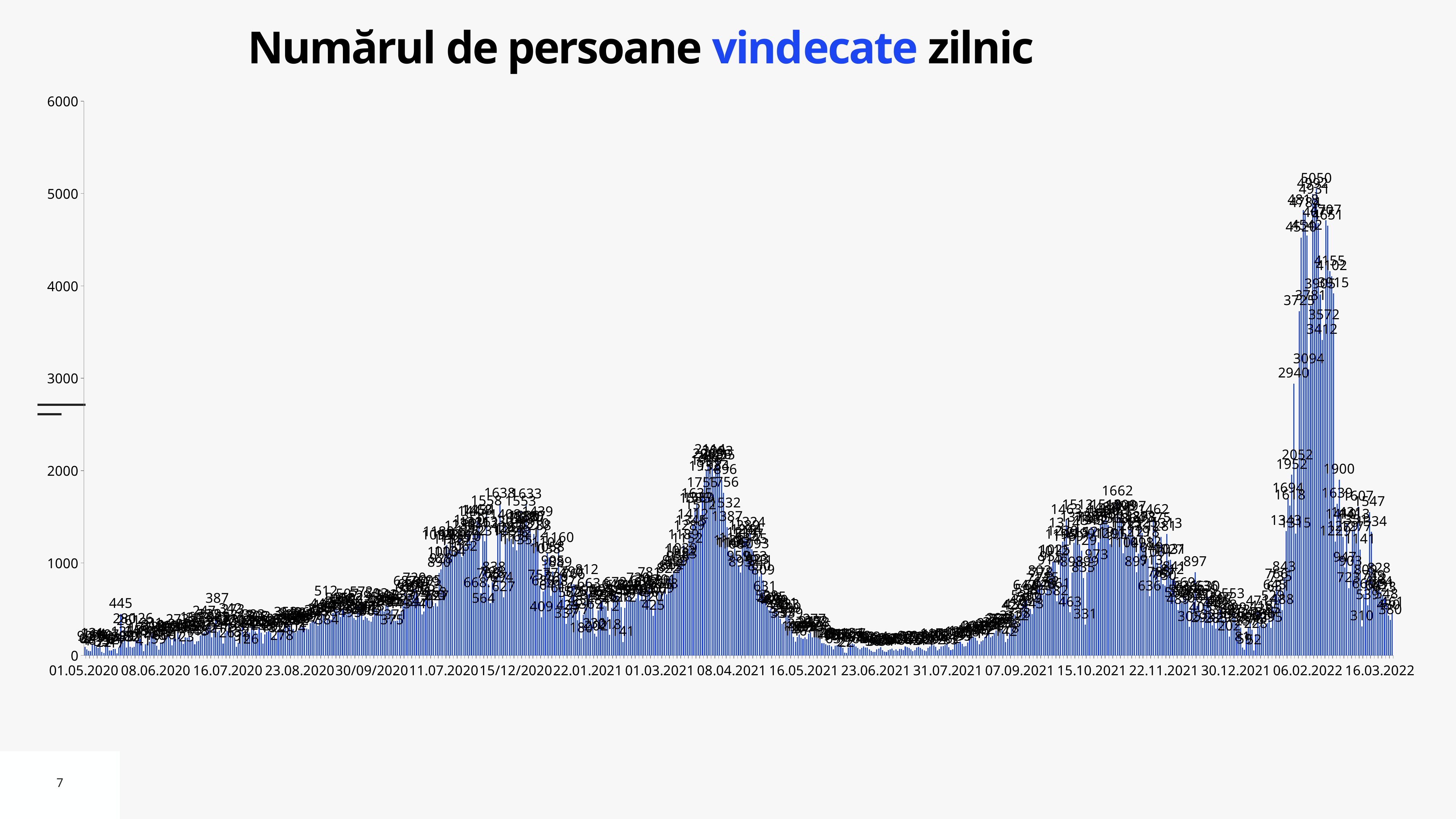
Is the value around 08.04.2021 greater or less than 1000? greater What kind of chart is shown on the slide? bar chart Is the value around 23.06.2021 greater or less than 500? less What is the highest value shown on the vertical axis? 6000 What is the title of the chart? Numărul de persoane vindecate zilnic Do the values rise or fall between 31.07.2021 and 07.09.2021? rise Is the value around 30.12.2021 greater or less than 1000? less What is the highest value labelled in the peak around 15.10.2021? 1662 Do the values rise or fall between 16.05.2021 and 23.06.2021? fall Which peak is higher: the one in April 2021 or the one in February–March 2022? February–March 2022 What is the highest value labelled on the chart? 5050